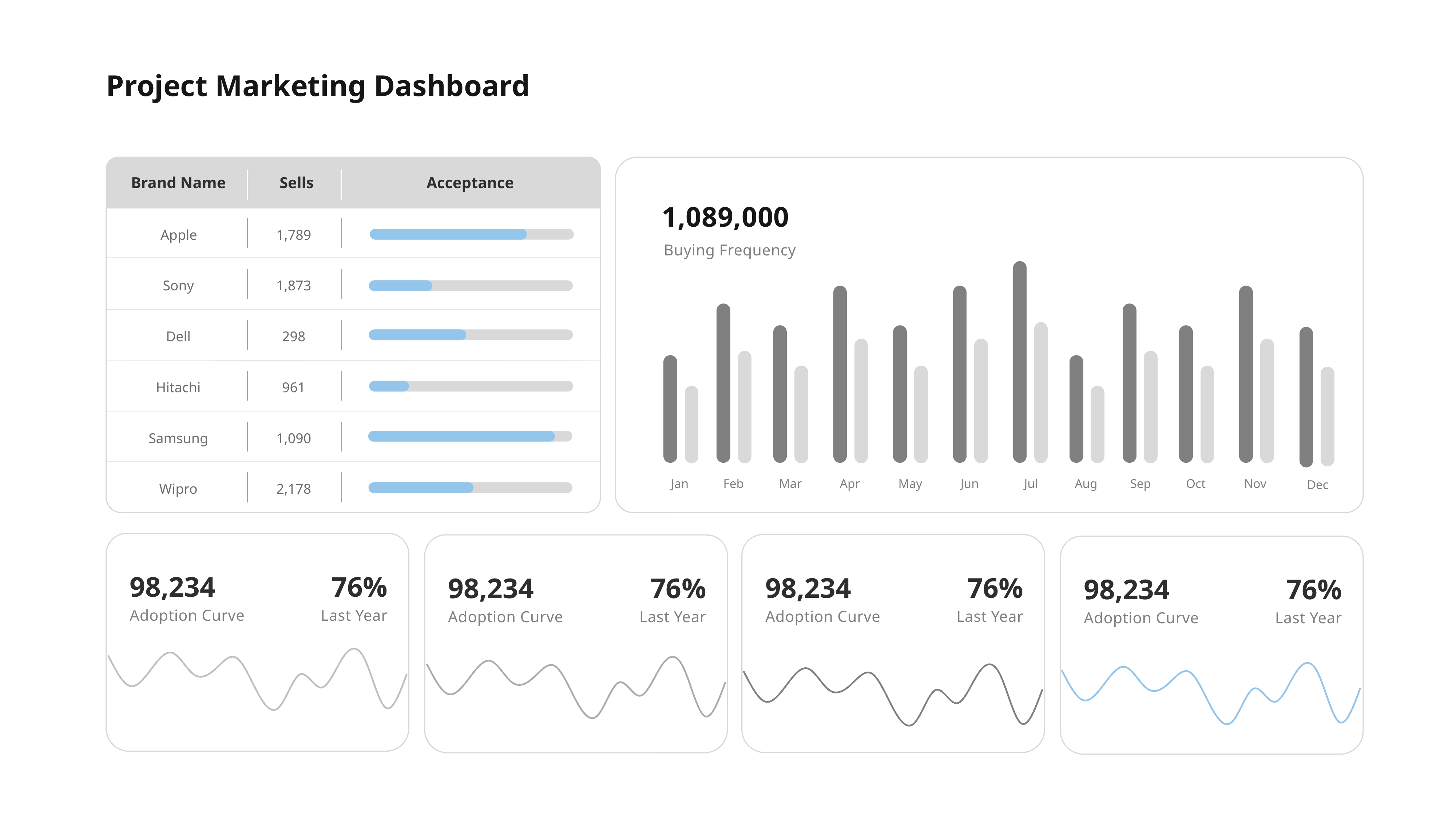
How many bars are drawn for each month in the Buying Frequency chart? 2 In the Buying Frequency chart, is the dark bar for Apr taller or shorter than the dark bar for Aug? taller In the Buying Frequency chart, which month has the tallest dark bar? Jul What kind of chart is the Buying Frequency chart? bar chart What colour is the line in the rightmost Adoption Curve chart? blue What headline figure is printed above the Buying Frequency chart? 1,089,000 In the Buying Frequency chart, which has the taller dark bar, Feb or Mar? Feb What kind of chart is shown in each of the four Adoption Curve cards at the bottom of the slide? line chart How many months are shown on the x axis of the Buying Frequency chart? 12 In the Buying Frequency chart, which month has the tallest light grey bar? Jul How many Adoption Curve line charts are on the slide? 4 In the Buying Frequency chart, is the dark bar for Jan taller or shorter than the light grey bar for Jan? taller